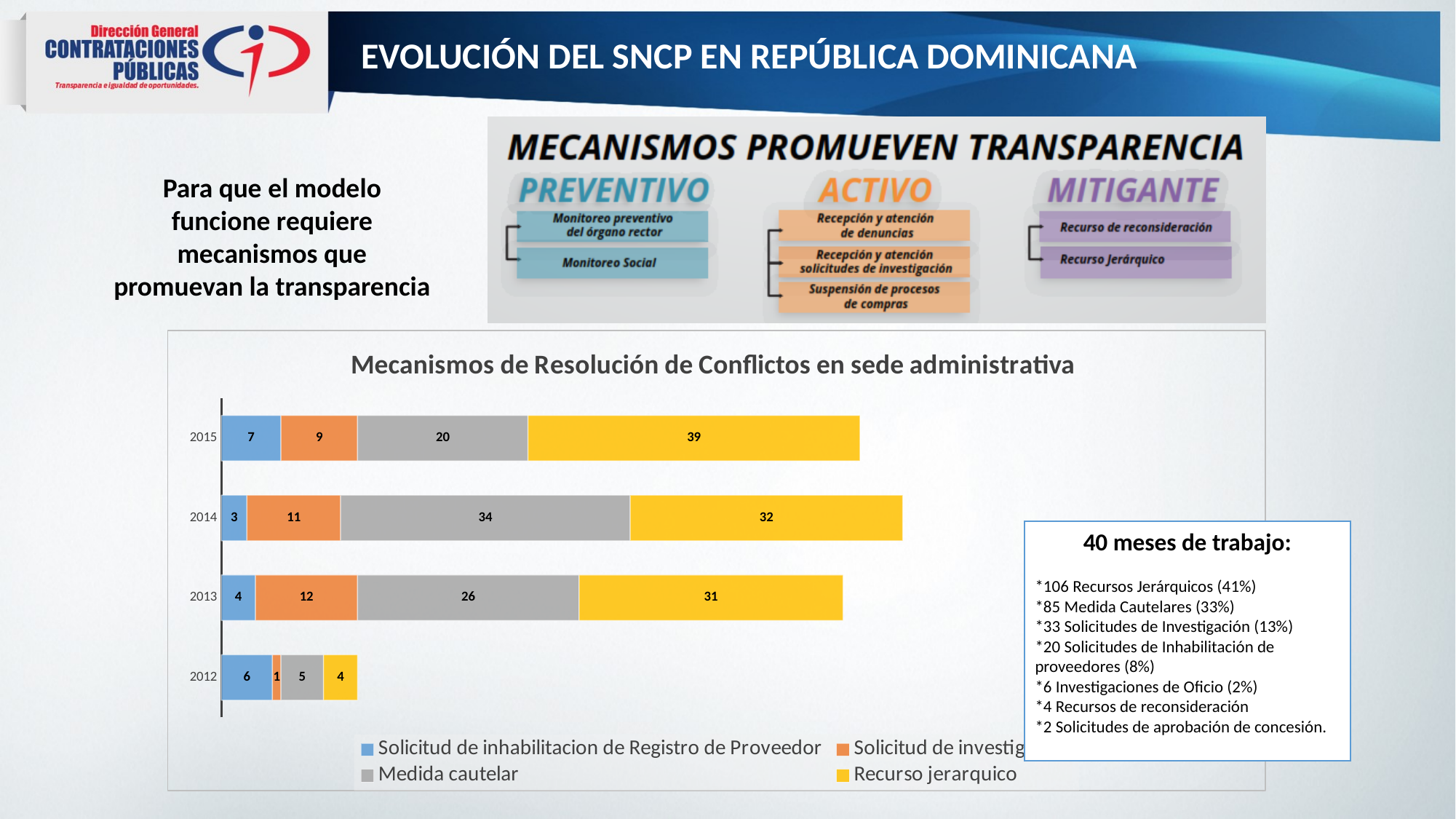
How many series does the chart's legend list? 4 Which year has the larger value for Recurso jerarquico, 2014 or 2013? 2014 What kind of chart is 'Mecanismos de Resolución de Conflictos en sede administrativa'? Stacked bar chart How many years are shown in the chart? 4 What is the value for Solicitud de inhabilitacion de Registro de Proveedor in 2012? 6 What is the total of the stacked bar for 2015? 75 Which year has the lowest value for Medida cautelar? 2012 Which year has the highest value for Recurso jerarquico? 2015 What is the total of the stacked bar for 2012? 16 What is the value for Medida cautelar in 2014? 34 In the chart 'Mecanismos de Resolución de Conflictos en sede administrativa', what is the value for Recurso jerarquico in 2015? 39 What is the difference between the Medida cautelar values for 2014 and 2013? 8